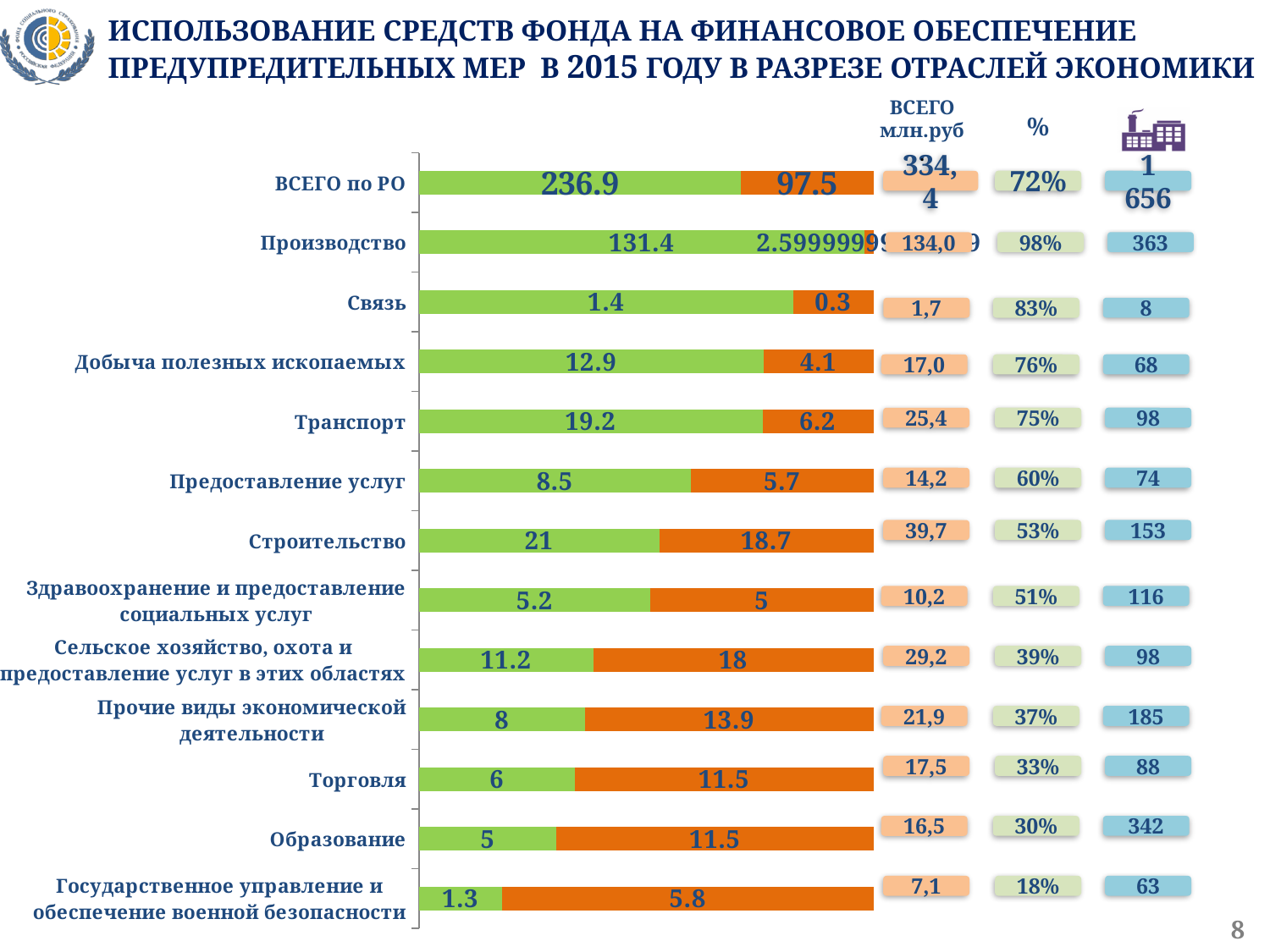
What is the difference between the green and orange segment values for Строительство? 2.3 What is the total of the green and orange segments for Связь? 1.7 What two colours are used for the bar segments in the chart? green and orange What is the value of the orange segment for Образование? 11.5 What kind of chart is shown on the slide? bar chart What is the value of the green segment for Добыча полезных ископаемых? 12.9 Which is larger: the green segment for Транспорт or the green segment for Добыча полезных ископаемых? Транспорт What is the value of the green segment for Транспорт? 19.2 Which category has the largest green segment value? ВСЕГО по РО What is the value of the orange segment for Строительство? 18.7 Which category has the smallest green segment value? Государственное управление и обеспечение военной безопасности How many categories (rows) does the bar chart show? 13